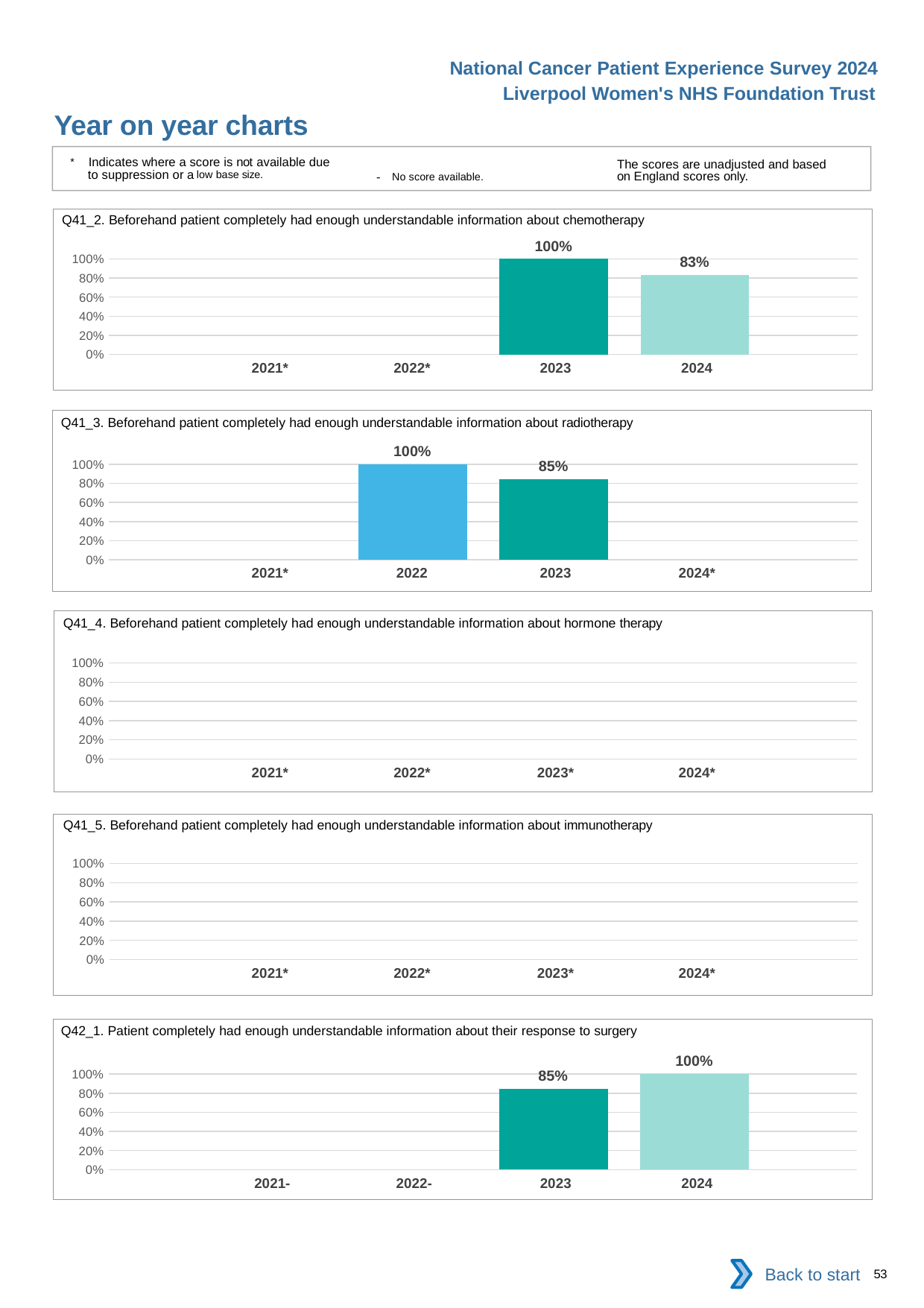
In the Q41_3 chart about radiotherapy, what is the value for 2022? 100% In the Q42_1 chart about response to surgery, what is the value for 2023? 85% In the Q42_1 chart about response to surgery, which year has the highest plotted value? 2024 How many year categories are shown on the x axis of the Q41_4 chart about hormone therapy? 4 In the Q42_1 chart about response to surgery, do the plotted values rise or fall from 2023 to 2024? rise In the Q41_2 chart about chemotherapy, what is the value for 2023? 100% In the Q41_3 chart about radiotherapy, which year has the lower plotted value, 2022 or 2023? 2023 In the Q41_2 chart about chemotherapy, what is the difference between the 2023 and 2024 values? 17 percentage points In the Q42_1 chart about response to surgery, what is the difference between the 2024 and 2023 values? 15 percentage points What kind of chart is the Q41_2 chart about chemotherapy? bar chart In the Q41_2 chart about chemotherapy, what is the value for 2024? 83% In the Q41_3 chart about radiotherapy, what is the value for 2023? 85%